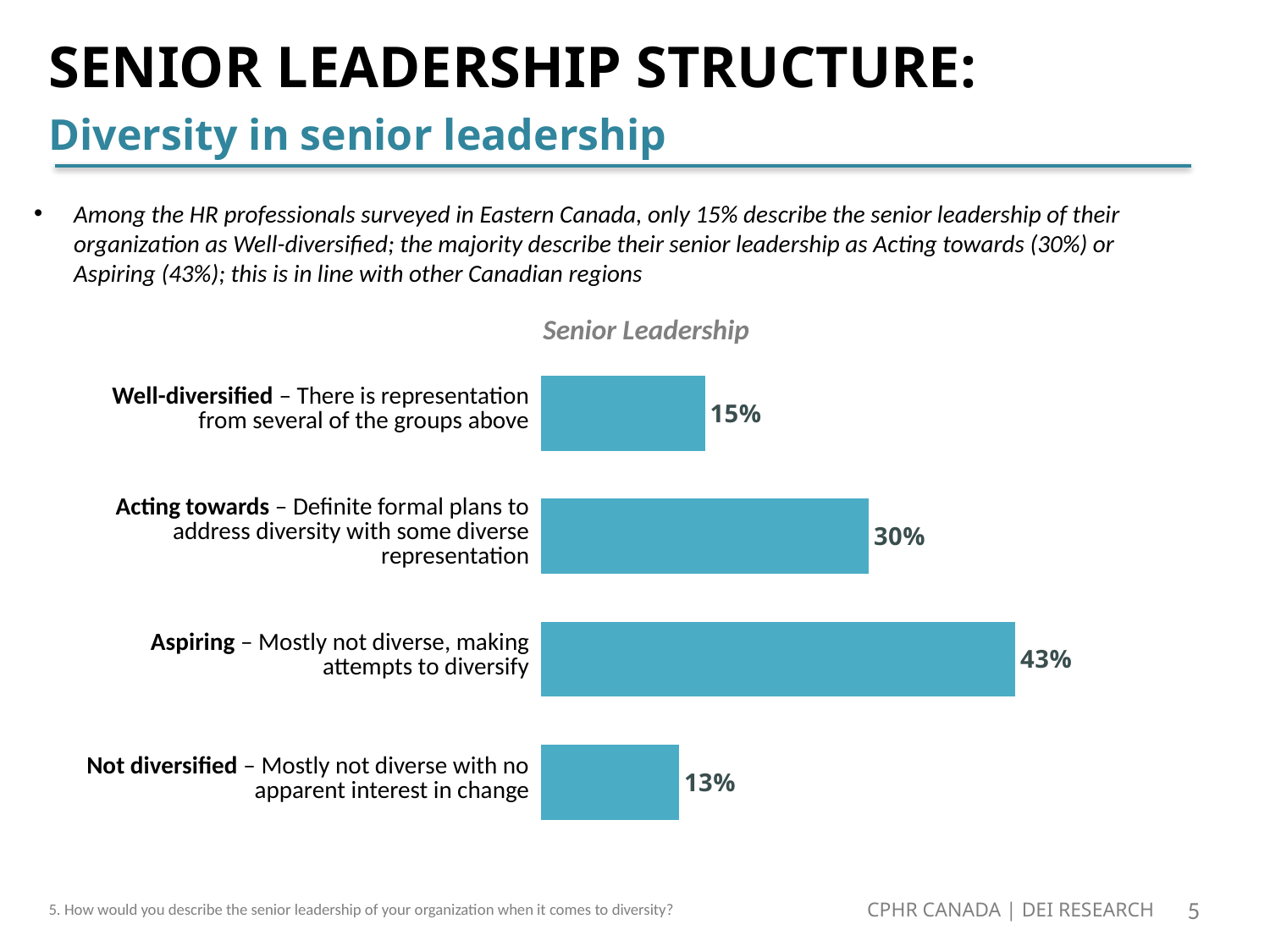
What value is shown for Not diversified? 13% How many categories are shown in the chart? 4 What is the difference between the Well-diversified and Not diversified values? 2% What percentage is shown for Aspiring? 43% What is the title of the chart? Senior Leadership What percentage of respondents describe their senior leadership as Well-diversified? 15% What is the difference between the Aspiring and Acting towards values? 13% Which category has the highest value in the chart? Aspiring Which category has the lowest value in the chart? Not diversified What value is shown for the Acting towards category? 30% What type of chart is shown on the slide? Bar chart Which is larger, the value for Acting towards or the value for Well-diversified? Acting towards